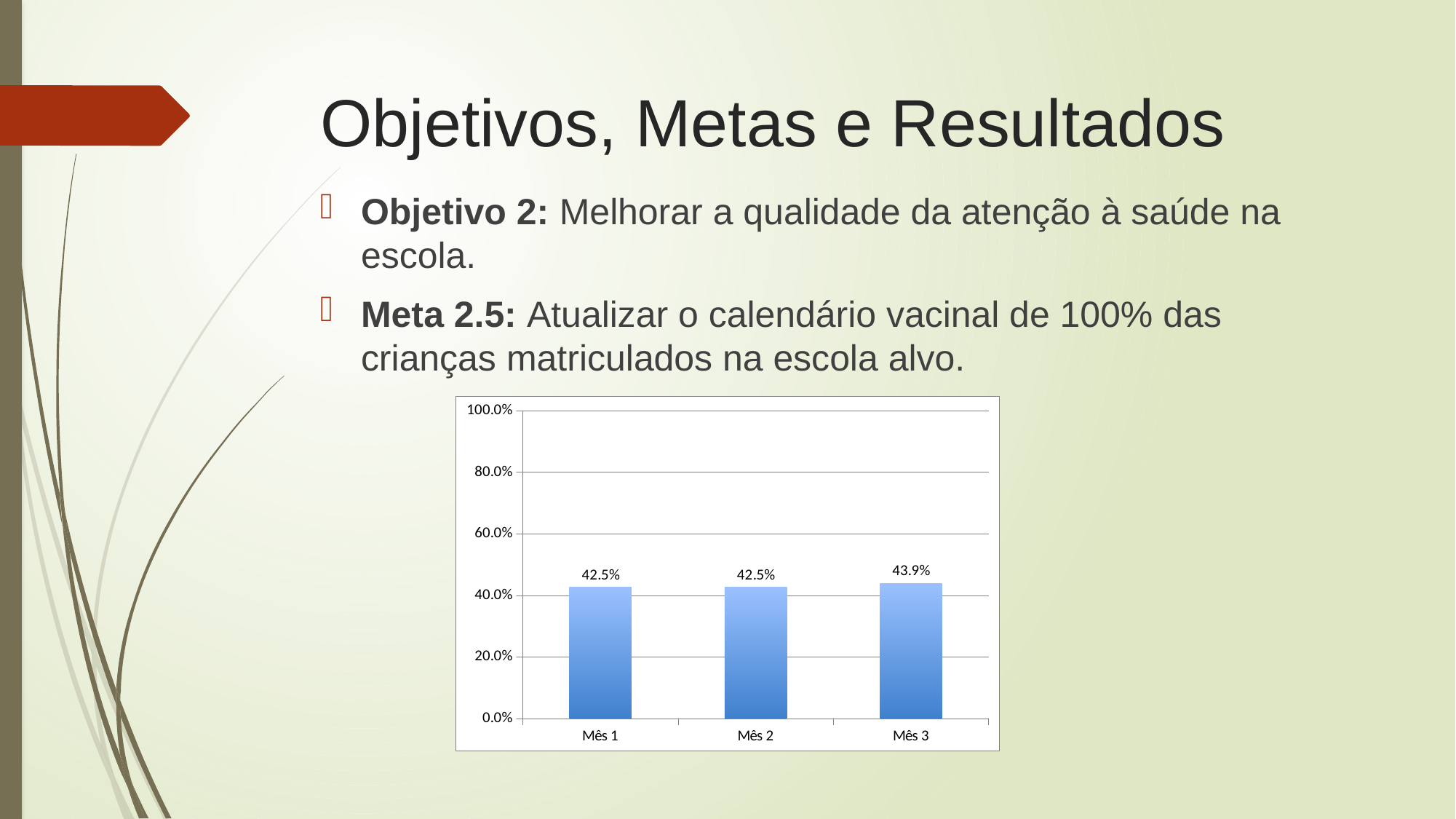
Which category has the highest value? Mês 3 What is the value for Mês 1? 42.5% Do the values rise or fall from Mês 2 to Mês 3? rise What is the value for Mês 3? 43.9% Are the values for Mês 1 and Mês 2 equal? yes What kind of chart is shown on the slide? bar chart What is the difference between the values for Mês 3 and Mês 1? 1.4% Is the value for Mês 3 greater or less than 40.0%? greater Is the value for Mês 2 greater or less than 60.0%? less What is the highest value shown on the y axis? 100.0% How many categories are shown on the x axis? 3 What is the value for Mês 2? 42.5%